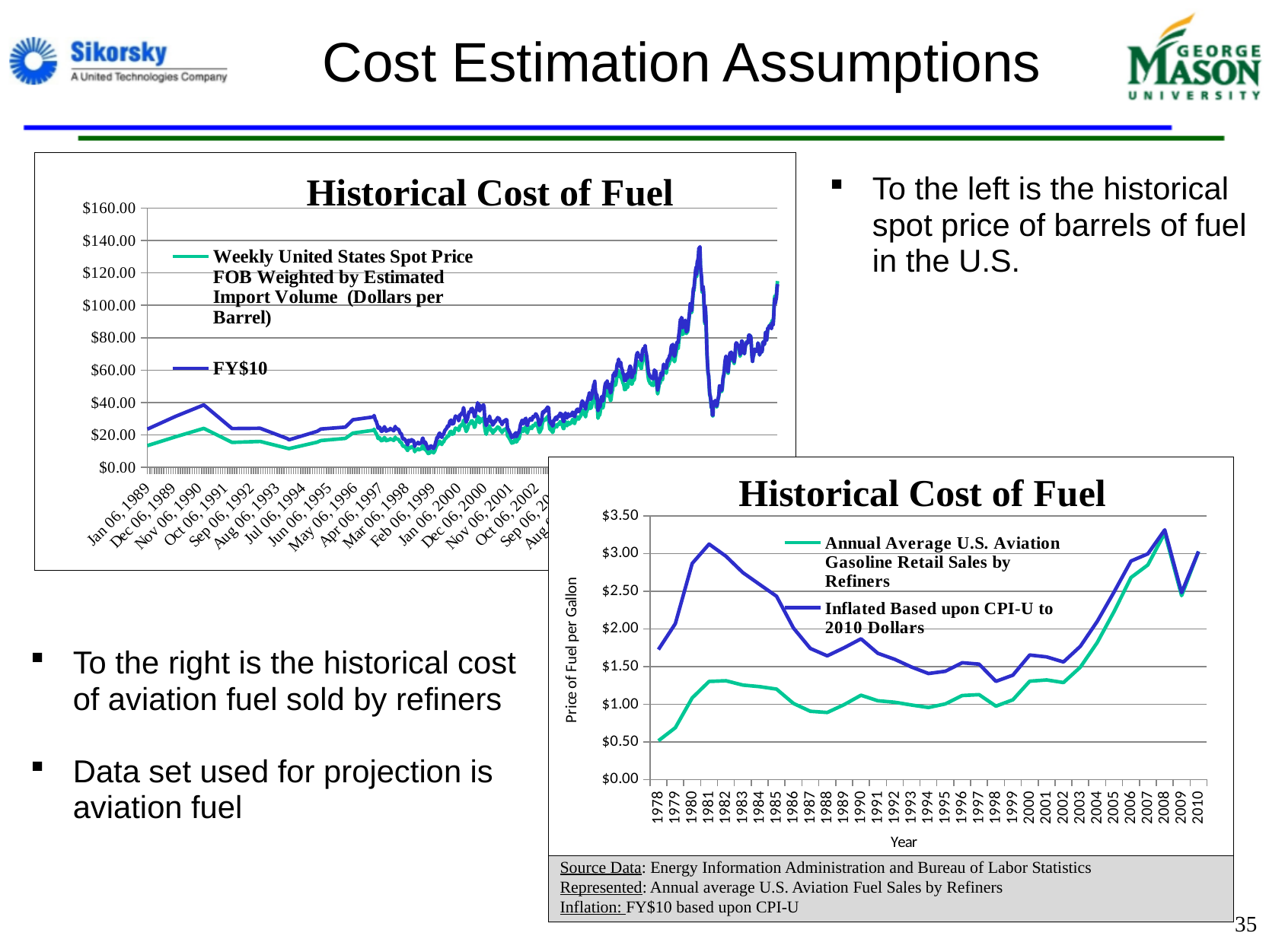
In the lower-right chart, does the 'Annual Average U.S. Aviation Gasoline Retail Sales by Refiners' series rise or fall from 2002 to 2008? rise In the lower-right chart, in which year does the 'Annual Average U.S. Aviation Gasoline Retail Sales by Refiners' series reach its highest value? 2008 How many series does the legend of the upper-left 'Historical Cost of Fuel' chart list? 2 In the upper-left chart, is the peak value of the 'FY$10' series greater or less than $120.00? greater What type of chart is the lower-right 'Historical Cost of Fuel' chart? line chart In the lower-right chart, is the 'Annual Average U.S. Aviation Gasoline Retail Sales by Refiners' value for 1988 greater or less than $1.00? less In the lower-right chart, is the 'Inflated Based upon CPI-U to 2010 Dollars' value for 1988 greater or less than $1.50? greater How many series does the legend of the lower-right 'Historical Cost of Fuel' chart list? 2 In the lower-right chart, how many years are shown on the x axis? 33 In the lower-right chart, does the 'Inflated Based upon CPI-U to 2010 Dollars' series rise or fall from 1981 to 1988? fall What is the y-axis title of the lower-right 'Historical Cost of Fuel' chart? Price of Fuel per Gallon